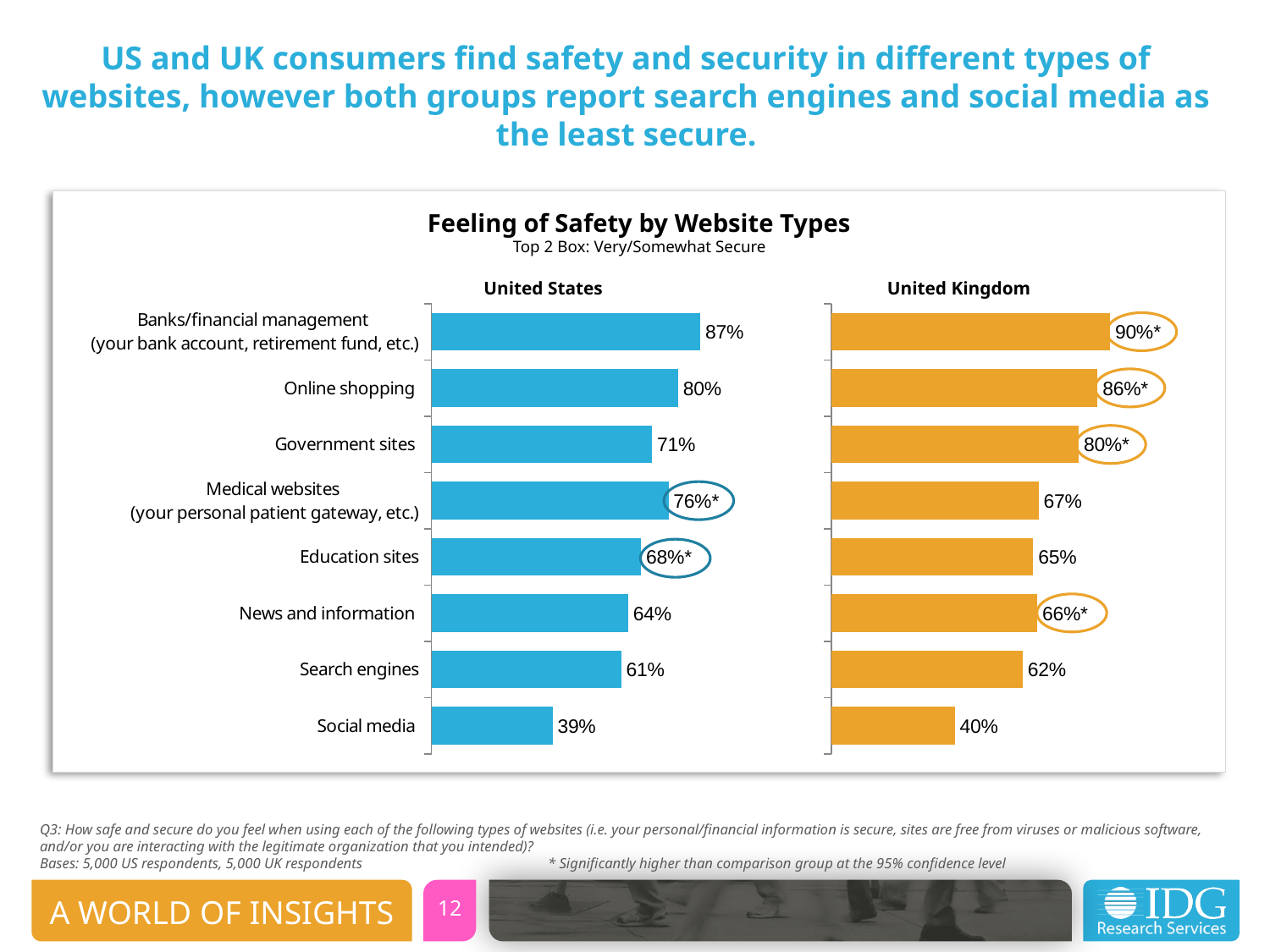
In the United Kingdom chart, what is the difference between medical websites and search engines? 5% Which is larger: the United States value for medical websites or the United Kingdom value for medical websites? United States In the United Kingdom chart, which website type has the highest value? Banks/financial management In the United States chart, which website type has the lowest value? Social media In the United Kingdom chart, what is the value for government sites? 80%* In the United States chart, what percentage of respondents feel secure on banks/financial management sites? 87% What kind of chart is used for the United Kingdom data? Bar chart In the United States chart, what is the value for search engines? 61% How many website types are shown in the United States chart? 8 In the United States chart, what is the difference between online shopping and government sites? 9% In the United Kingdom chart, what is the value for social media? 40% What is the title of the chart on the slide? Feeling of Safety by Website Types